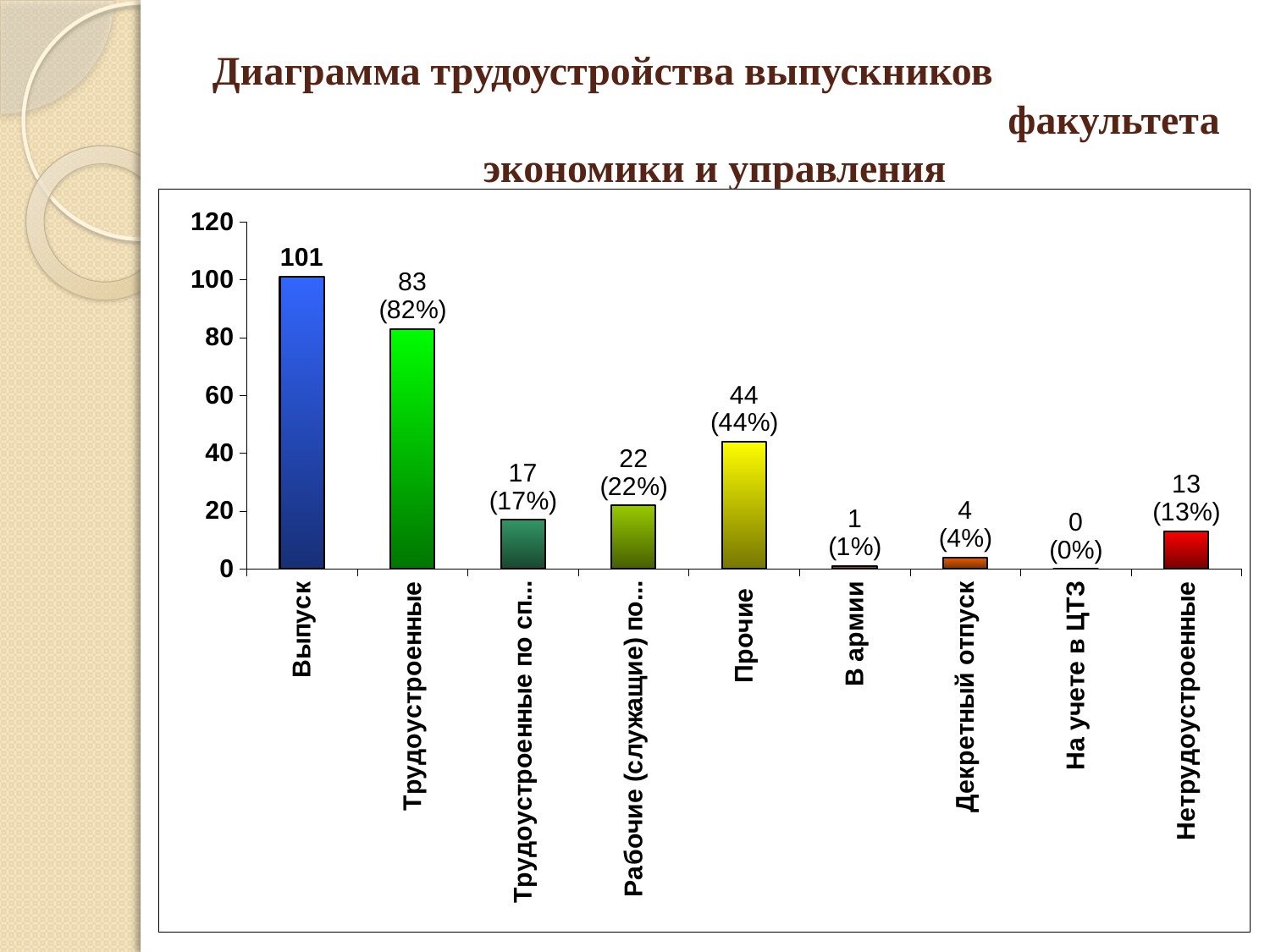
What is the value for Выпуск? 101 Which is larger, the value for Нетрудоустроенные or the value for Декретный отпуск? Нетрудоустроенные What is the highest value shown on the y axis? 120 What value is shown for Прочие? 44 (44%) Which category has the highest value? Выпуск What value is shown for Трудоустроенные? 83 (82%) Which category has the lowest value? На учете в ЦТЗ What is the difference between the values for Выпуск and Трудоустроенные? 18 What kind of chart is shown on the slide? Bar chart What value is shown for Нетрудоустроенные? 13 (13%) What value is shown for Декретный отпуск? 4 (4%) How many categories are shown on the x axis? 9